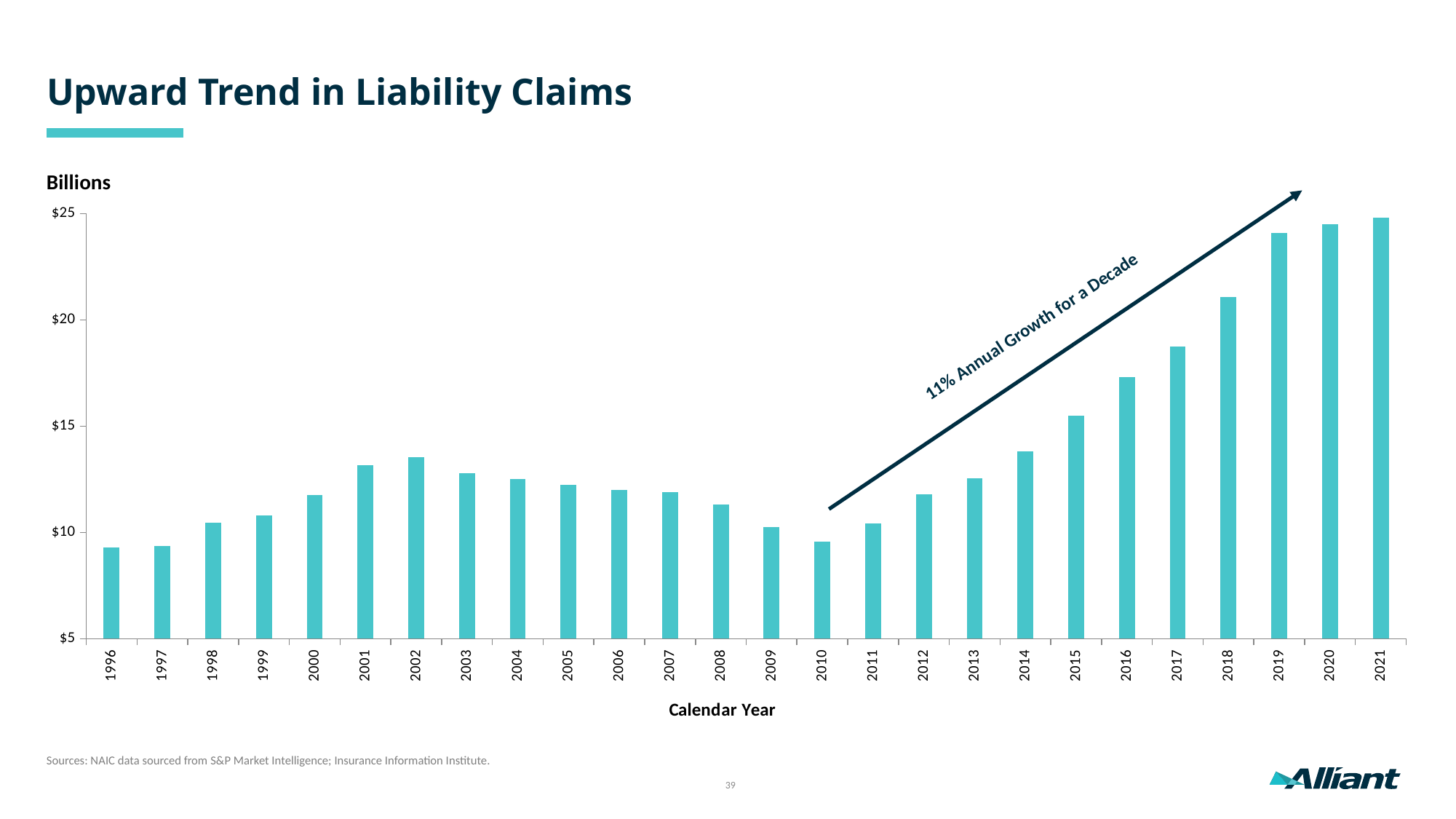
Is the value for 2021 greater or less than $20? greater Do the values rise or fall from 2010 to 2021? rise Is the value for 2010 greater or less than $10? less What is the title of the chart? Upward Trend in Liability Claims Is the value for 2016 greater or less than $15? greater What does the annotation along the arrow say? 11% Annual Growth for a Decade Which year has the highest value? 2021 What kind of chart is shown on the slide? Bar chart How many years are plotted on the x axis? 26 Which is larger, the value for 2021 or the value for 1996? 2021 Which is larger, the value for 2002 or the value for 2009? 2002